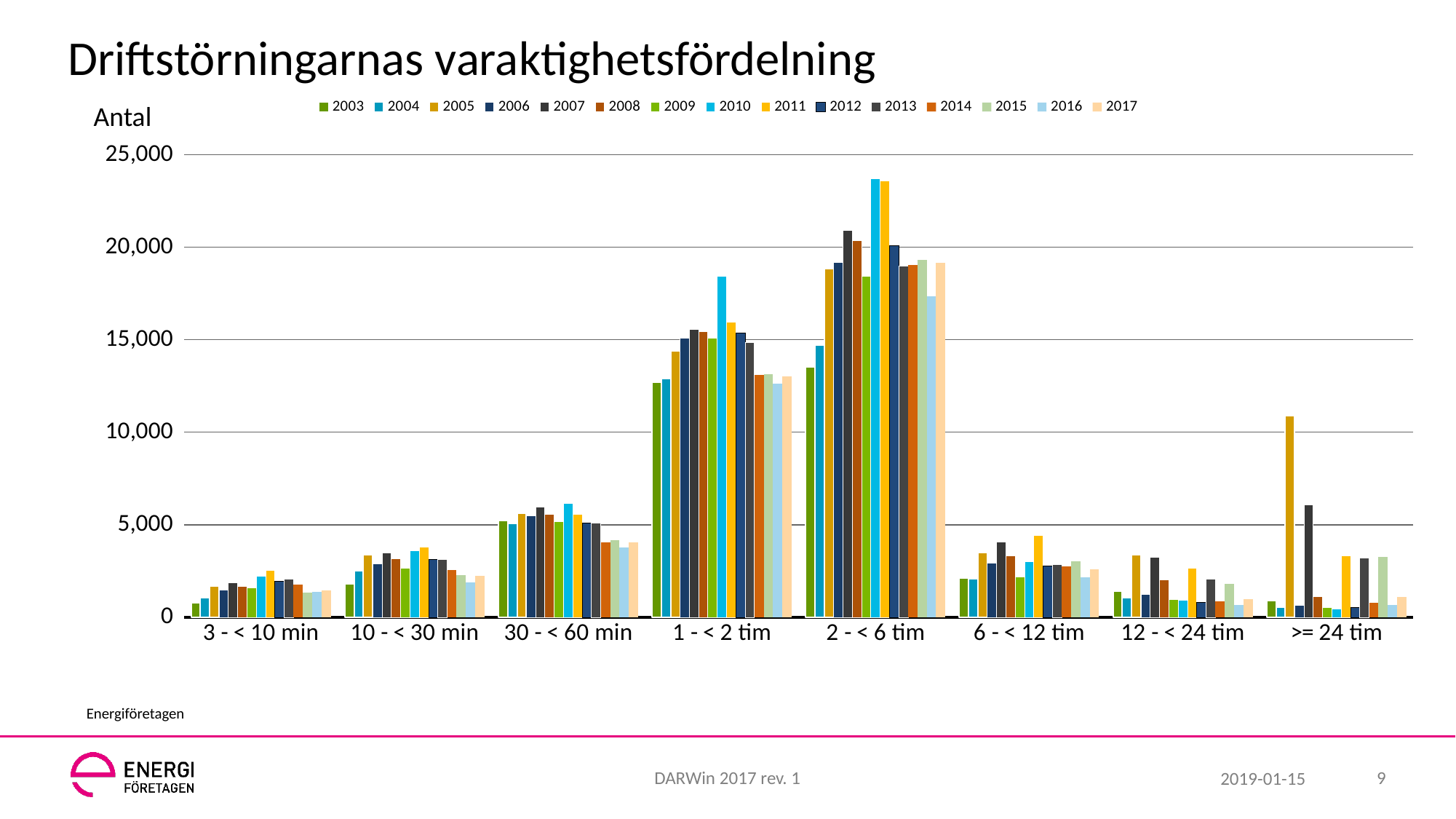
Is the value for 2010 in the "30 - < 60 min" category greater or less than 5,000? greater Which year has the highest value in the "1 - < 2 tim" category? 2010 Which year has the highest value in the ">= 24 tim" category? 2005 Is the value for 2005 in the ">= 24 tim" category greater or less than 10,000? greater What kind of chart is shown on the slide? bar chart Is the value for 2017 in the "2 - < 6 tim" category greater or less than 15,000? greater What label is shown on the vertical axis? Antal Which duration category has the tallest bars overall? 2 - < 6 tim How many duration categories are shown on the x axis? 8 How many series (years) does the legend list? 15 What is the title of the chart? Driftstörningarnas varaktighetsfördelning